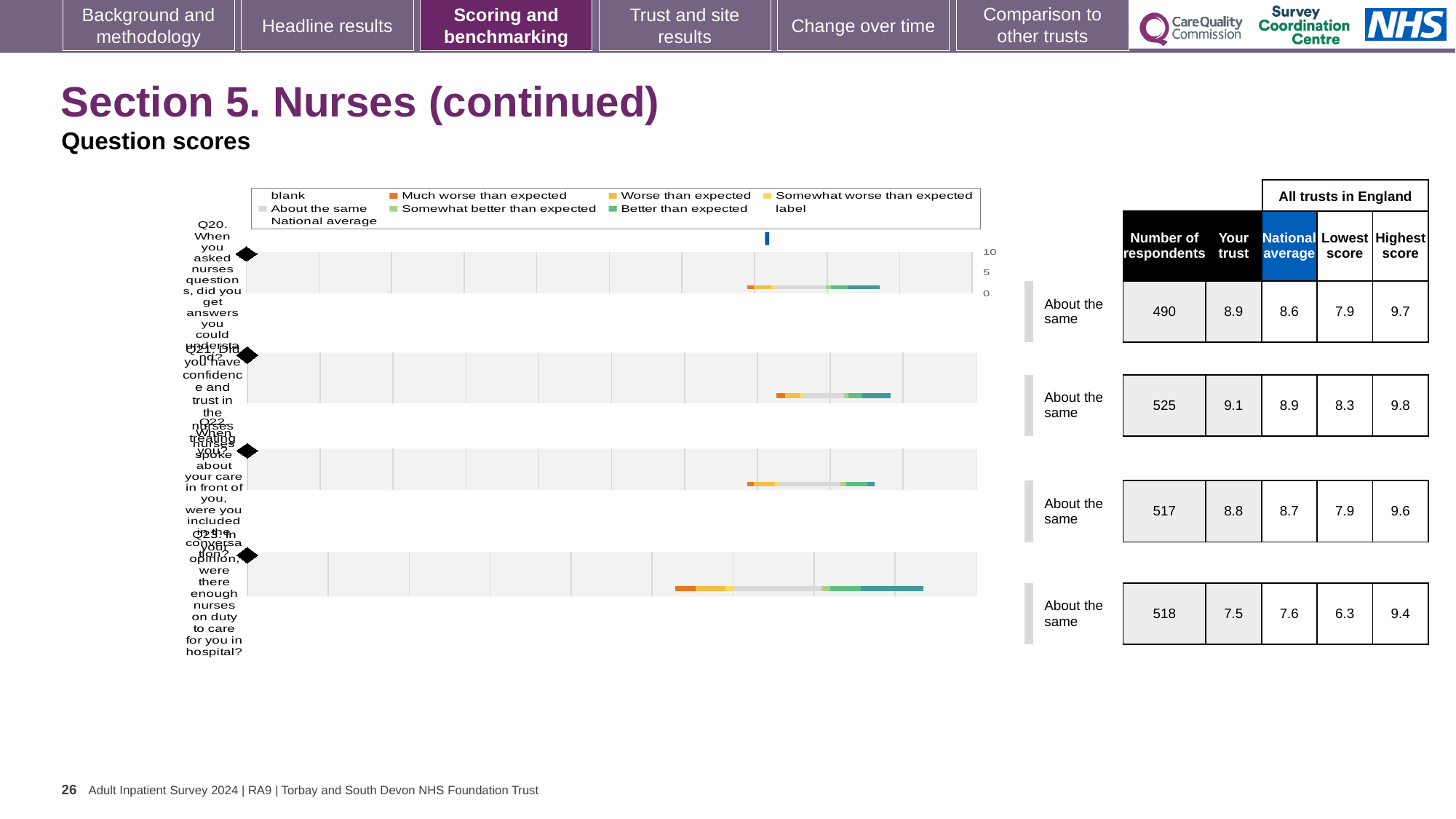
What is the difference between the 'Your trust' score and the national average for Q20? 0.3 Which question has the highest 'Your trust' score? Q21 How many questions (categories) are plotted in the chart? 4 What is the highest score among all trusts in England for Q22? 9.6 What is the national average score for Q23 (enough nurses on duty)? 7.6 For Q23, which is larger: the 'Your trust' score or the national average? National average Which question has the lowest 'Your trust' score? Q23 How many respondents answered Q20? 490 What is the lowest score among all trusts in England for Q23? 6.3 What kind of chart is shown on the slide? bar chart What is the 'Your trust' score for Q21 (confidence and trust in the nurses)? 9.1 What benchmark category is shown for each of the four questions? About the same